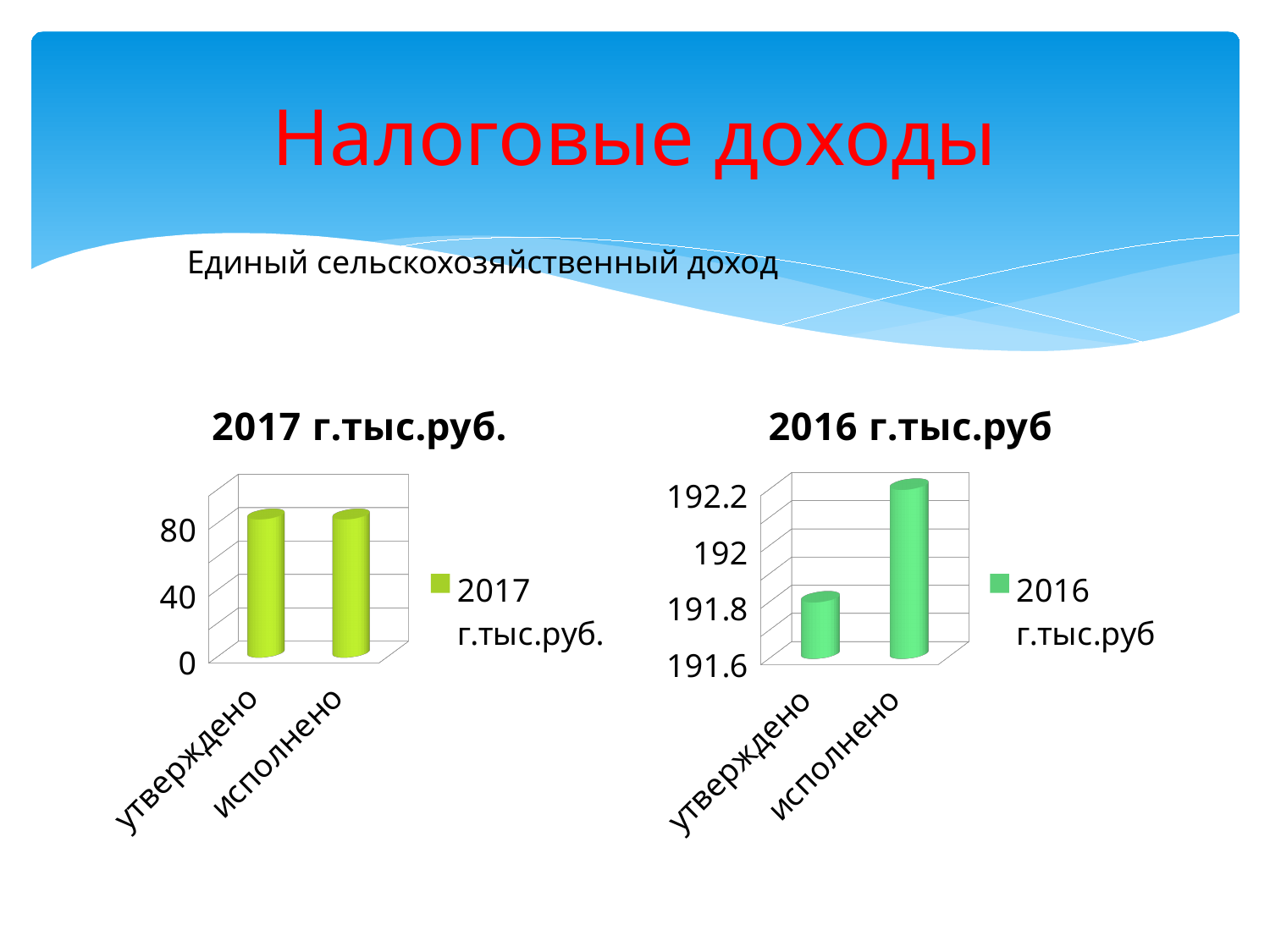
What is the legend entry of the "2017 г.тыс.руб." chart? 2017 г.тыс.руб. In the "2016 г.тыс.руб" chart, is the value for исполнено greater or less than 192? greater How many series does the legend of the "2016 г.тыс.руб" chart list? 1 What type of chart is the "2017 г.тыс.руб." chart on the left? bar chart In the "2016 г.тыс.руб" chart, which category has the lowest value? утверждено In the "2016 г.тыс.руб" chart, which category has the highest value? исполнено How many categories are shown on the x axis of the "2017 г.тыс.руб." chart? 2 In the "2017 г.тыс.руб." chart, is the value for утверждено greater or less than 40? greater How many categories are shown on the x axis of the "2016 г.тыс.руб" chart? 2 In the "2016 г.тыс.руб" chart, which is larger: утверждено or исполнено? исполнено What type of chart is the "2016 г.тыс.руб" chart on the right? bar chart In the "2016 г.тыс.руб" chart, is the value for утверждено greater or less than 192? less